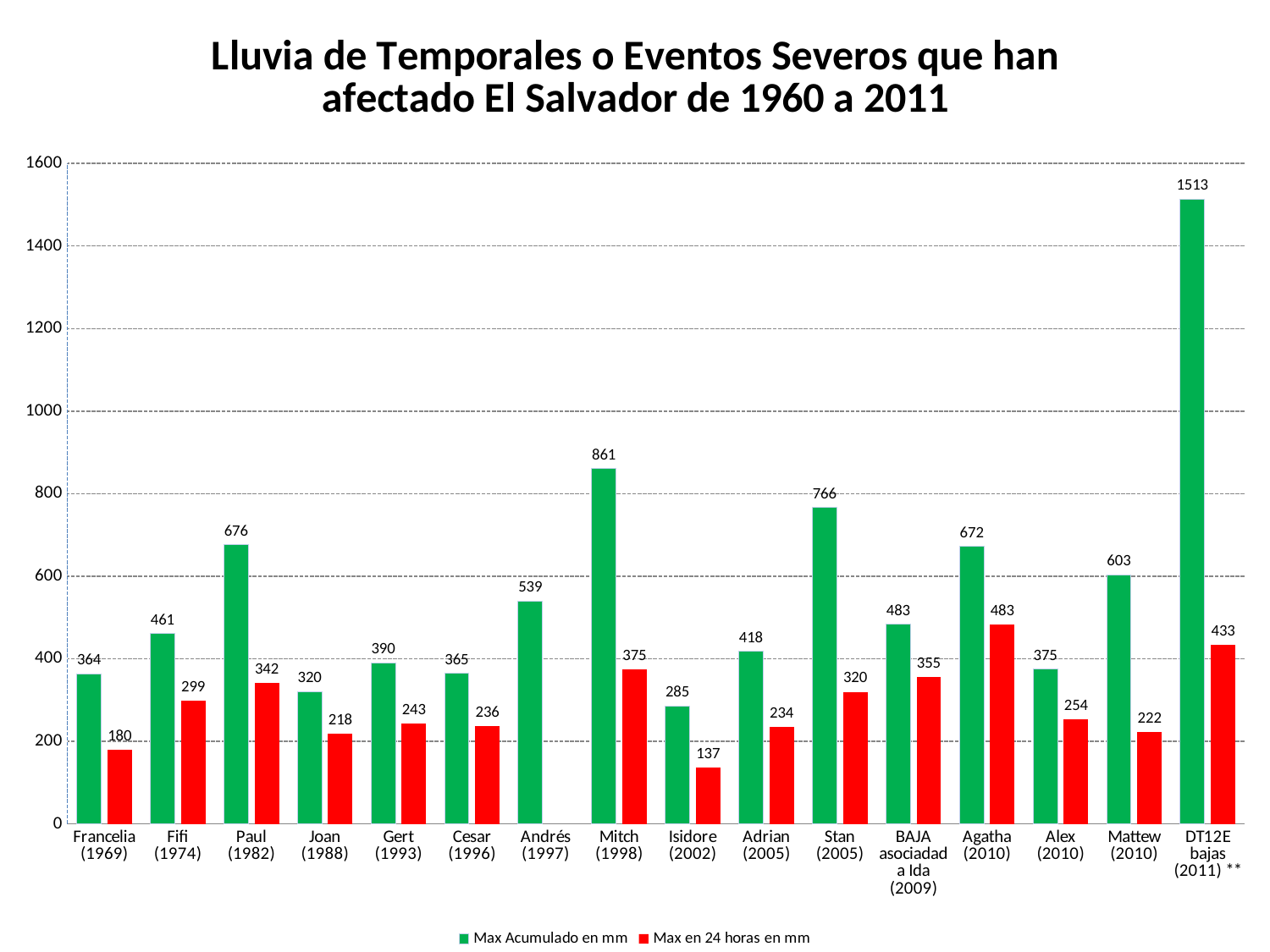
What kind of chart is shown on the slide? Bar chart How many events are shown on the x axis? 16 What colour are the Max en 24 horas en mm bars? Red Which event has the lowest Max en 24 horas en mm? Isidore (2002) What is the Max Acumulado en mm value for Mitch (1998)? 861 What is the difference between the Max Acumulado en mm and the Max en 24 horas en mm for Stan (2005)? 446 What is the Max en 24 horas en mm value for Agatha (2010)? 483 Which event has no Max en 24 horas en mm bar shown? Andrés (1997) What is the Max en 24 horas en mm value for Isidore (2002)? 137 Which is larger, the Max Acumulado en mm for Paul (1982) or for Agatha (2010)? Paul (1982) Which event has the highest Max Acumulado en mm? DT12E bajas (2011) ** How many series does the legend list? 2